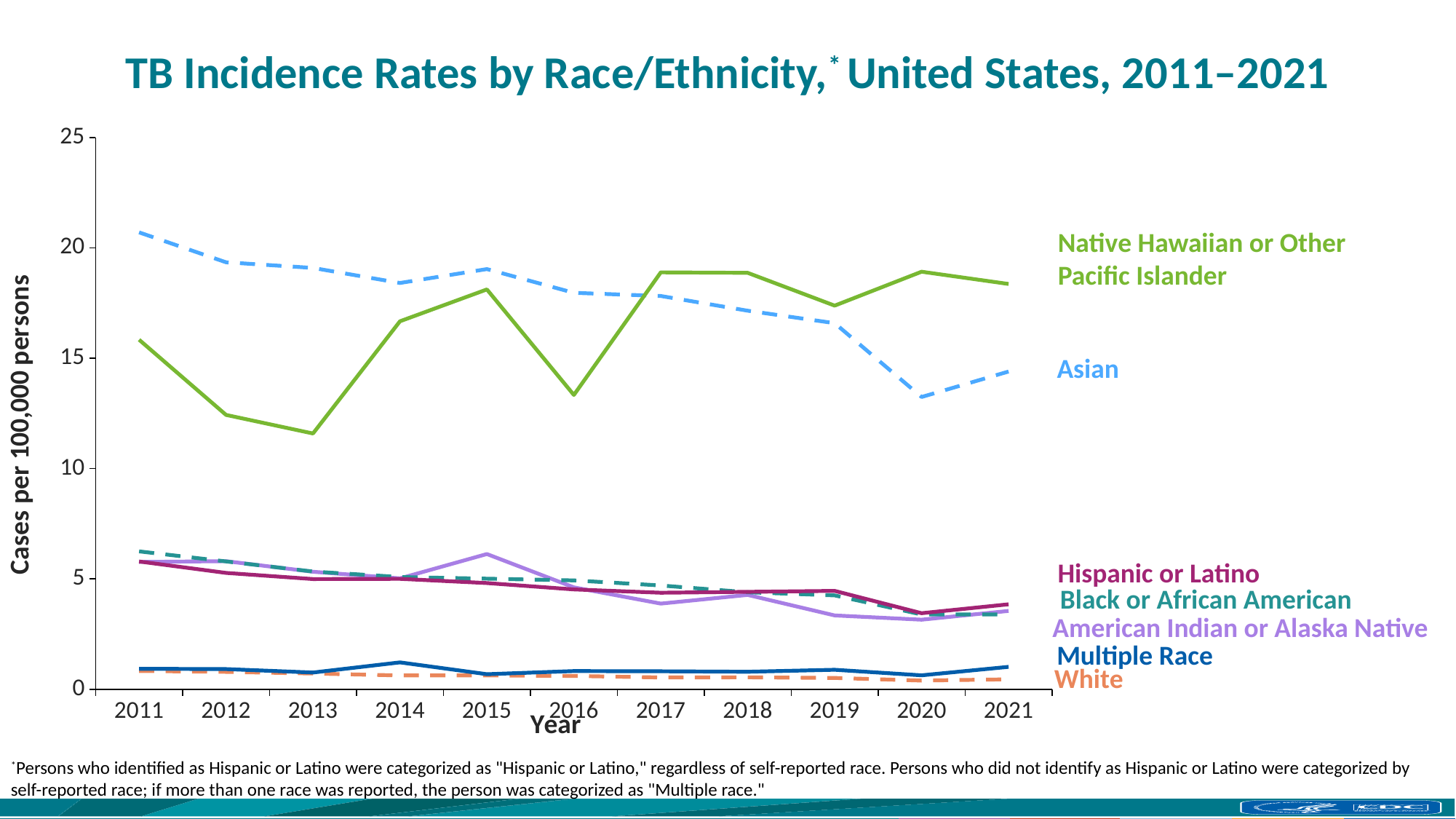
How many years are shown along the x axis? 11 What is the label on the y axis of the chart? Cases per 100,000 persons In 2015, which group had the higher TB incidence rate: American Indian or Alaska Native, or Hispanic or Latino? American Indian or Alaska Native Is the TB incidence rate for Native Hawaiian or Other Pacific Islander persons in 2013 greater or less than 10? greater Which race/ethnicity group had the lowest TB incidence rate in 2021? White Is the TB incidence rate for Asian persons in 2020 greater or less than 15? less How many race/ethnicity groups (series) are plotted on the chart? 7 In 2021, which group had the higher TB incidence rate: Native Hawaiian or Other Pacific Islander, or Asian? Native Hawaiian or Other Pacific Islander Is the TB incidence rate for White persons in 2011 greater or less than 5? less Which race/ethnicity group had the highest TB incidence rate in 2011? Asian Does the TB incidence rate for Asian persons generally rise or fall from 2011 to 2021? fall What kind of chart is shown on the slide? line chart